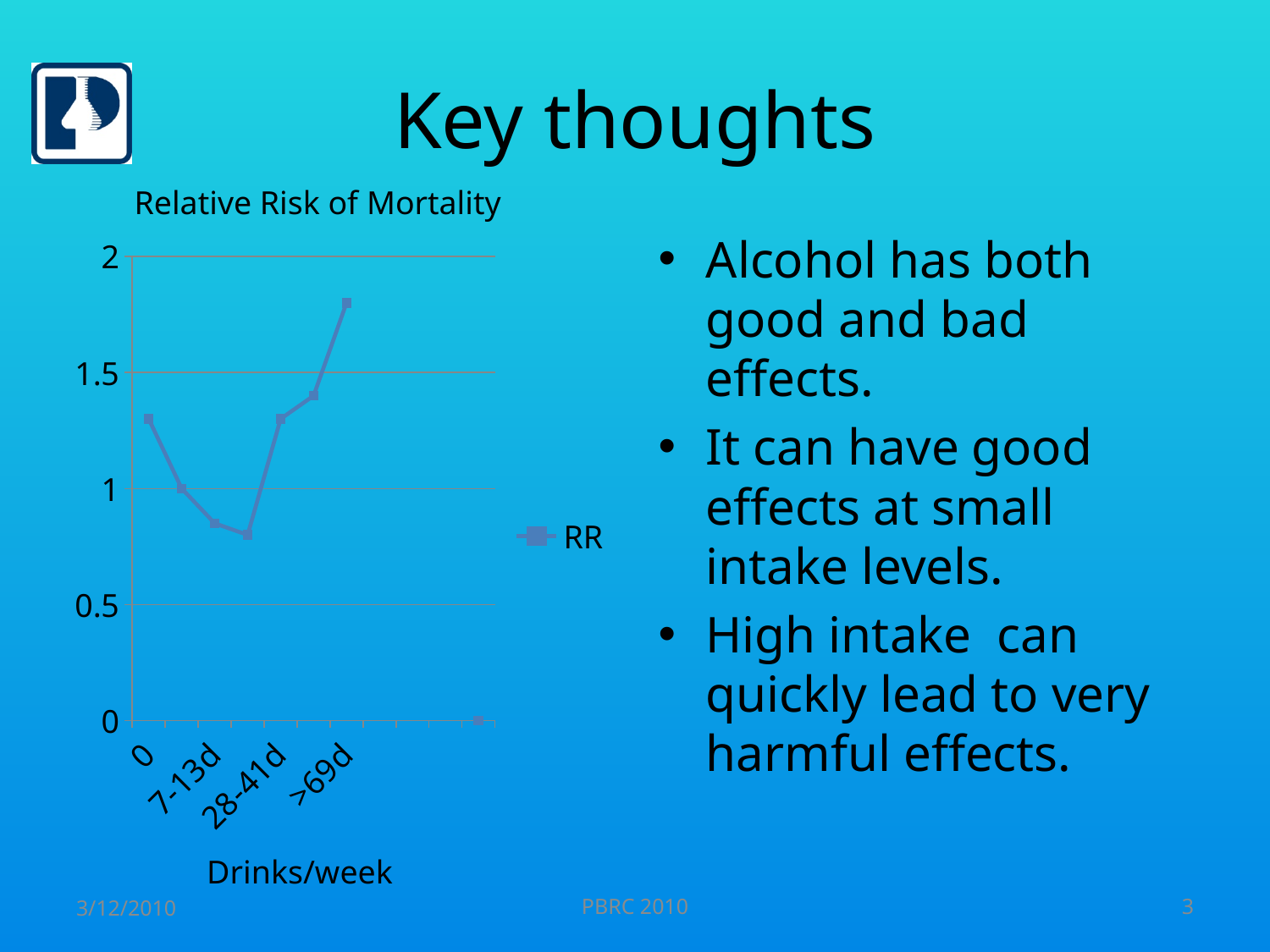
How many series does the chart legend list? 1 Which has the larger value, 7-13d or 28-41d? 28-41d What is the name of the series shown in the legend? RR Is the value for 28-41d greater or less than 1.5? less Which of the labelled categories has the highest relative risk value? >69d Is the value for 7-13d greater or less than 1.5? less How does the relative risk change as drinks per week increase along the x axis? It falls at first, then rises Is the value for 0 drinks/week greater or less than 1? greater What kind of chart is shown on the slide? line chart What is the title of the chart? Relative Risk of Mortality Which has the larger value, 0 or >69d? >69d